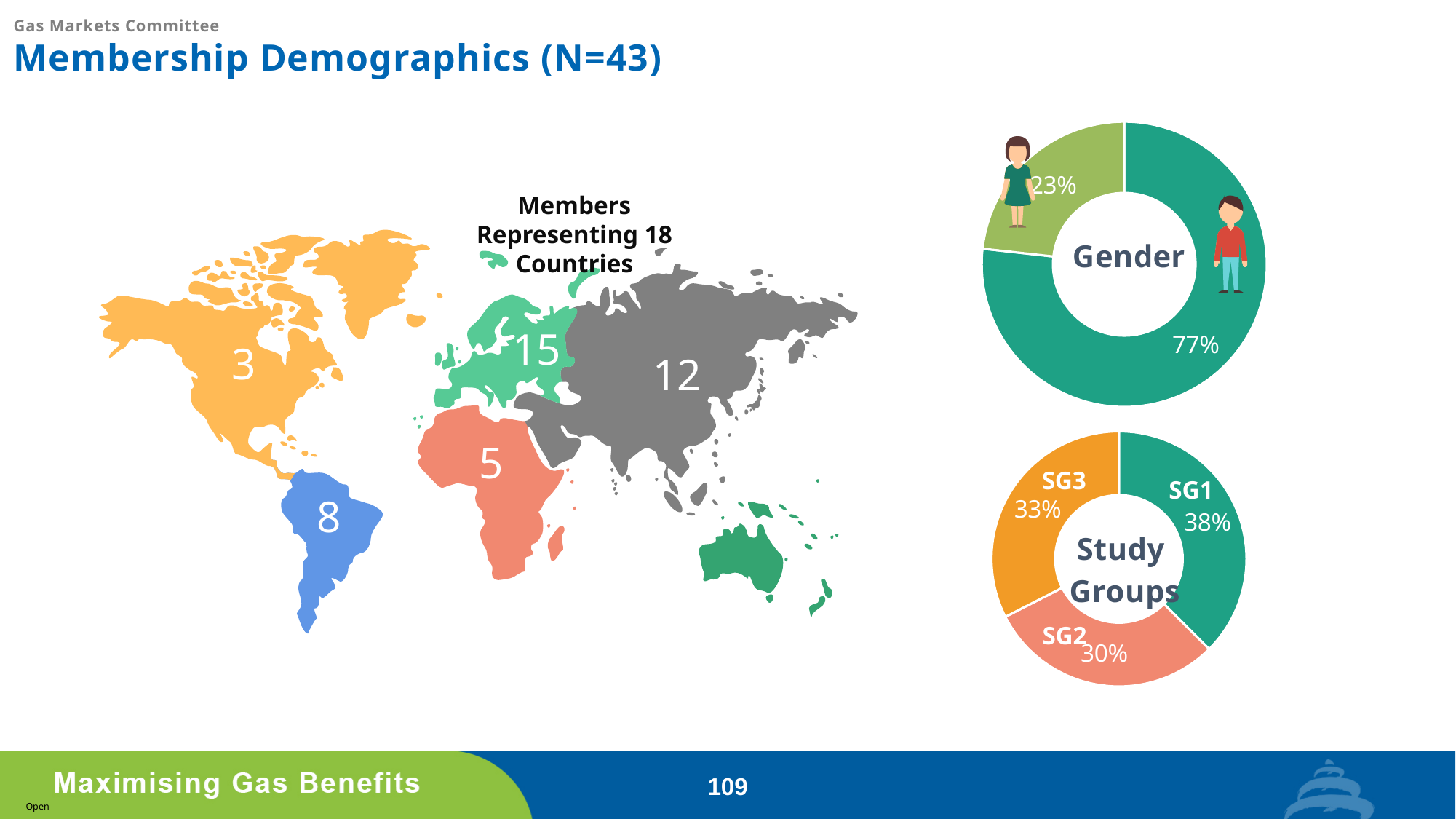
In the Gender chart, what percentage is shown for the larger segment? 77% In the Study Groups chart, how many study groups are shown? 3 In the Gender chart, what is the difference between the two segments' percentages? 54% In the Gender chart, what percentage is shown for the smaller segment? 23% In the Study Groups chart, which study group has the smallest share? SG2 On the world map, how many countries do the members represent according to the label? 18 In the Study Groups chart, what percentage is shown for SG2? 30% In the Study Groups chart, what percentage is shown for SG3? 33% What kind of chart is the Gender chart? Donut chart In the Study Groups chart, which study group has the largest share? SG1 In the Study Groups chart, what is the difference between the SG1 and SG2 percentages? 8% In the Study Groups chart, what percentage is shown for SG1? 38%